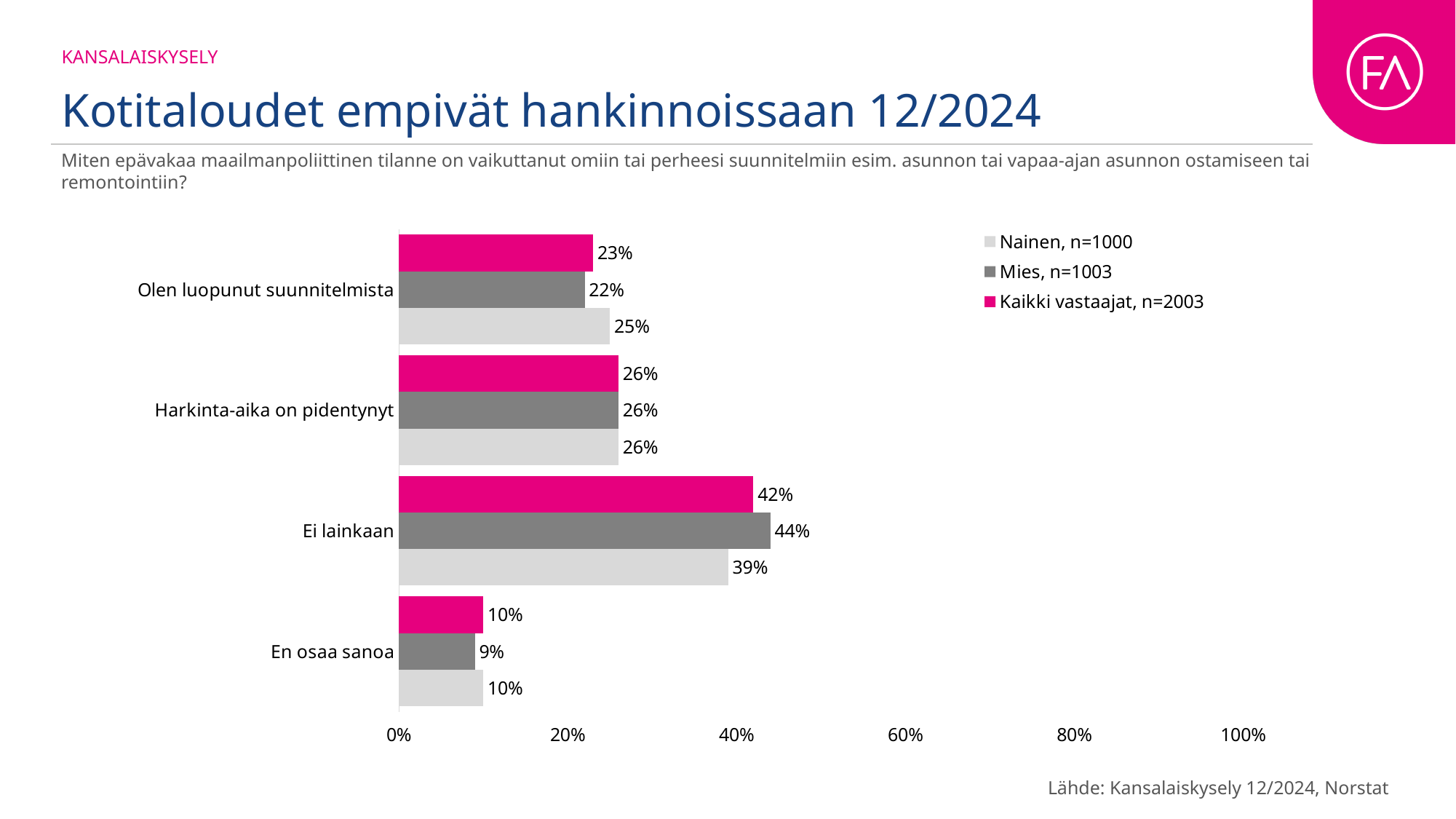
What is the value for "Olen luopunut suunnitelmista" in the "Nainen, n=1000" series? 25% What is the difference between the "Mies, n=1003" and "Nainen, n=1000" values for "Ei lainkaan"? 5% How many categories are shown on the chart? 4 For "Olen luopunut suunnitelmista", which is larger: the "Nainen, n=1000" value or the "Mies, n=1003" value? Nainen, n=1000 What kind of chart is shown on the slide? Bar chart Is the "Kaikki vastaajat, n=2003" value for "Ei lainkaan" greater or less than 40%? greater Which category has the highest value in the "Kaikki vastaajat, n=2003" series? Ei lainkaan Which category has the lowest value in the "Mies, n=1003" series? En osaa sanoa Which colour represents the "Kaikki vastaajat, n=2003" series? Pink What is the value for "Ei lainkaan" in the "Mies, n=1003" series? 44% How many series does the legend list? 3 What is the value for "En osaa sanoa" in the "Kaikki vastaajat, n=2003" series? 10%